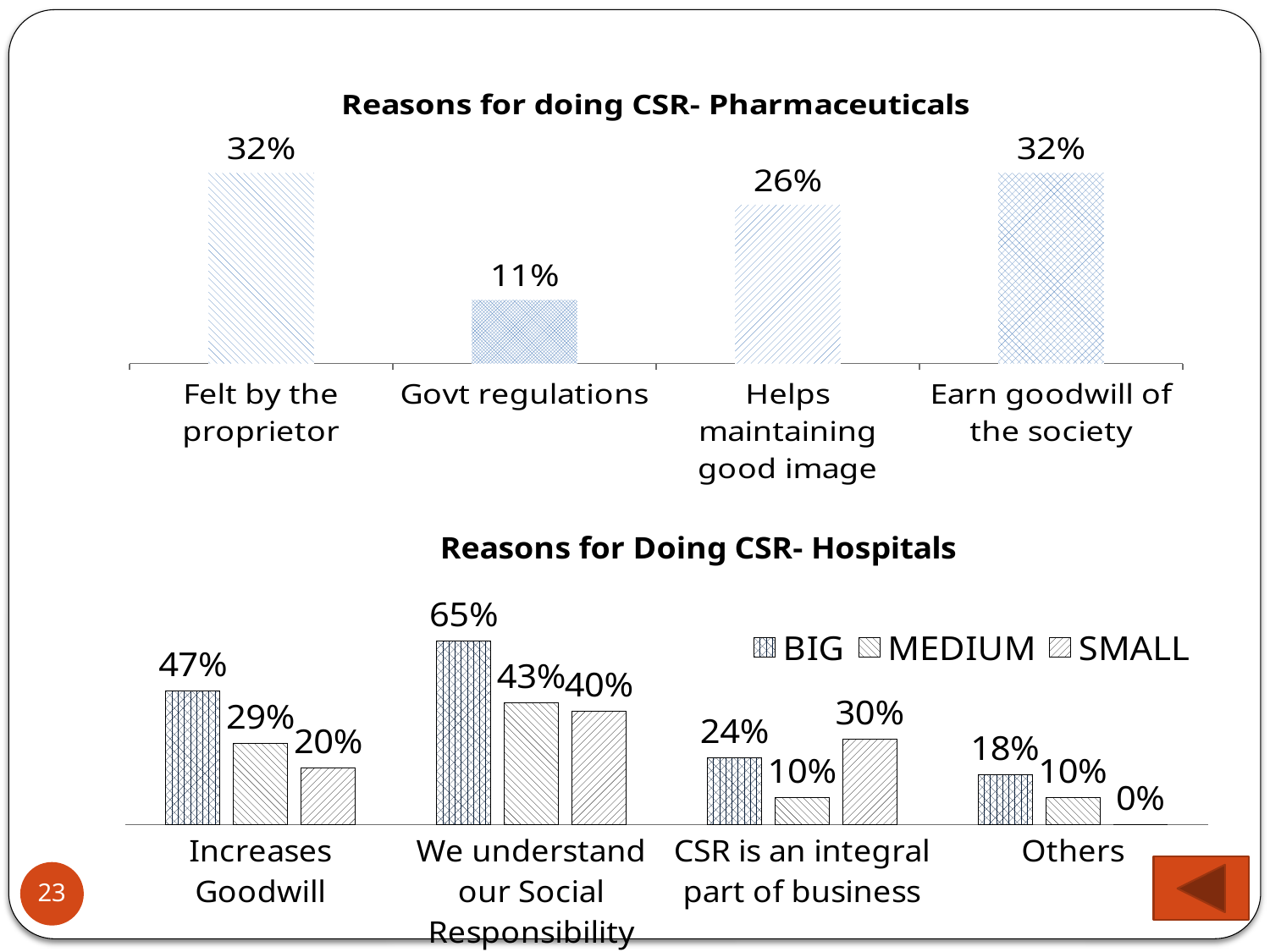
In the 'Reasons for doing CSR- Pharmaceuticals' chart, what is the value for Govt regulations? 11% In the 'Reasons for Doing CSR- Hospitals' chart, what is the BIG value for 'We understand our Social Responsibility'? 65% In the 'Reasons for doing CSR- Pharmaceuticals' chart, which category has the lowest value? Govt regulations In the 'Reasons for Doing CSR- Hospitals' chart, what is the difference between the BIG and MEDIUM values for 'Increases Goodwill'? 18% In the 'Reasons for doing CSR- Pharmaceuticals' chart, what is the value for 'Earn goodwill of the society'? 32% In the 'Reasons for doing CSR- Pharmaceuticals' chart, how many categories are shown? 4 In the 'Reasons for Doing CSR- Hospitals' chart, which series has the highest value for 'CSR is an integral part of business'? SMALL What type of chart is the 'Reasons for Doing CSR- Hospitals' chart? Bar chart In the 'Reasons for doing CSR- Pharmaceuticals' chart, what is the difference between 'Felt by the proprietor' and 'Helps maintaining good image'? 6% In the 'Reasons for Doing CSR- Hospitals' chart, which is larger for 'Increases Goodwill': MEDIUM or SMALL? MEDIUM In the 'Reasons for Doing CSR- Hospitals' chart, how many series does the legend list? 3 In the 'Reasons for Doing CSR- Hospitals' chart, what is the SMALL value for Others? 0%